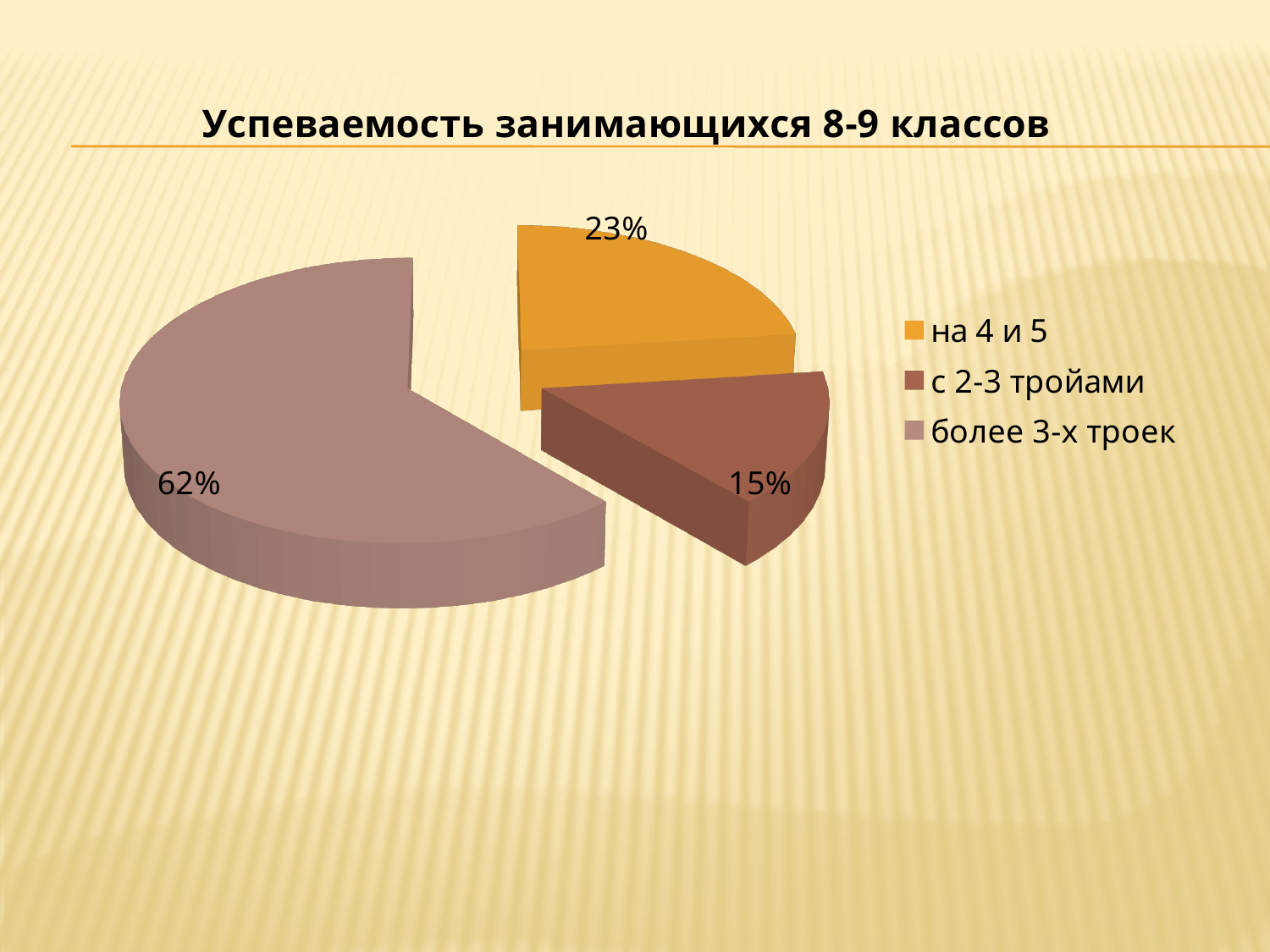
What is the difference in percentage points between the 'на 4 и 5' slice and the 'с 2-3 тройами' slice? 8 Which category has the smallest slice of the pie? с 2-3 тройами What is the difference in percentage points between the 'более 3-х троек' slice and the 'на 4 и 5' slice? 39 What share of the pie does the 'на 4 и 5' slice represent? 23% What colour is the 'на 4 и 5' slice? orange What share of the pie does the 'с 2-3 тройами' slice represent? 15% What kind of chart is shown on the slide? pie chart What is the title of the chart? Успеваемость занимающихся 8-9 классов How many categories does the pie chart show? 3 Which category has the largest slice of the pie? более 3-х троек What share of the pie does the 'более 3-х троек' slice represent? 62% Which is larger: the 'на 4 и 5' slice or the 'с 2-3 тройами' slice? на 4 и 5